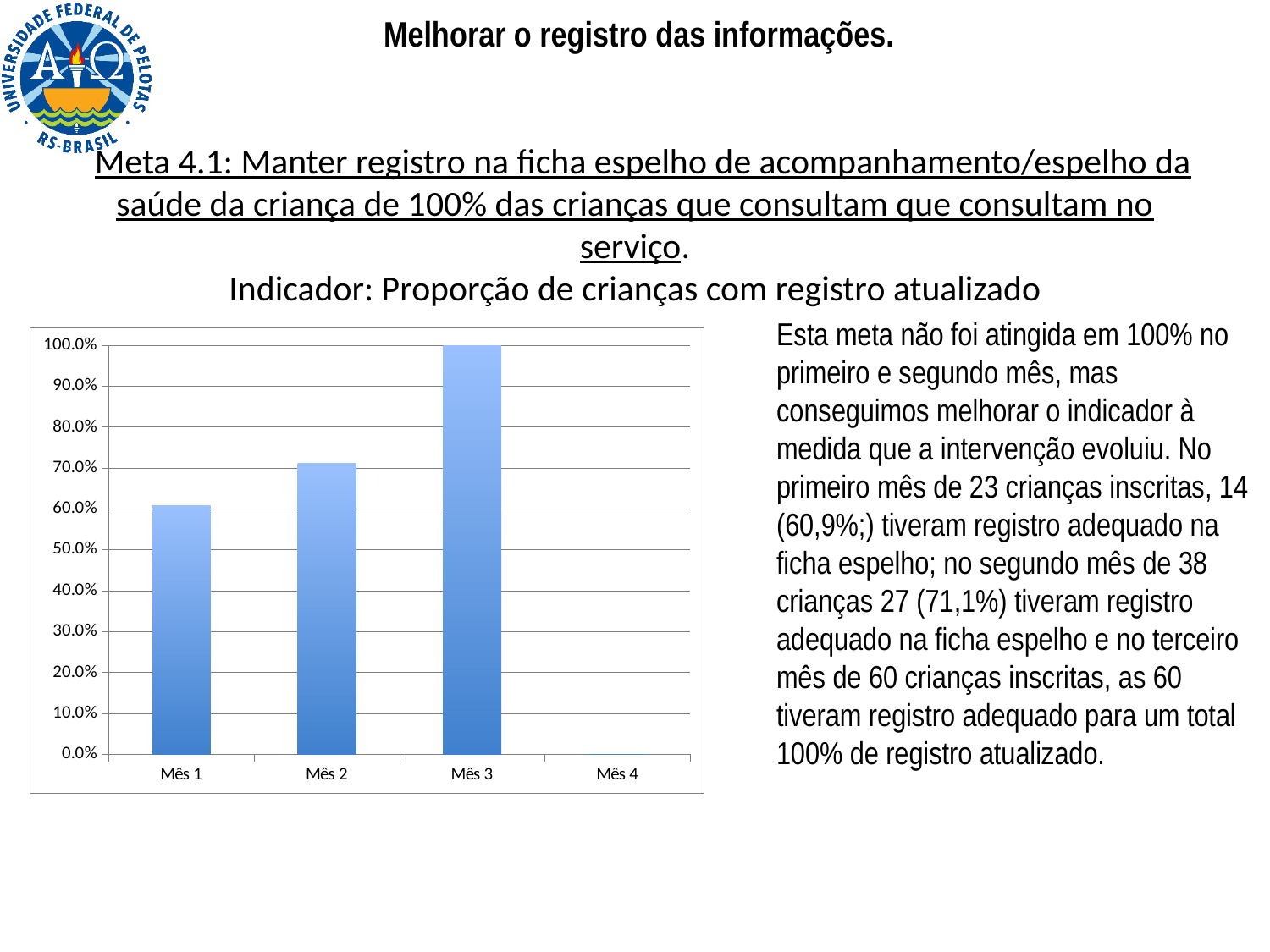
Is the value for Mês 1 greater or less than 70%? less Which month has the highest value? Mês 3 Is the value for Mês 2 greater or less than 80%? less Is the value for Mês 1 greater or less than 50%? greater How many bars are plotted in the chart? 3 Do the values rise or fall from Mês 1 to Mês 3? rise Which of the plotted months has the lowest value? Mês 1 How many categories are labelled on the x axis? 4 What is the value for Mês 3? 100.0% What kind of chart is shown on the slide? bar chart Which is larger, the value for Mês 1 or the value for Mês 2? Mês 2